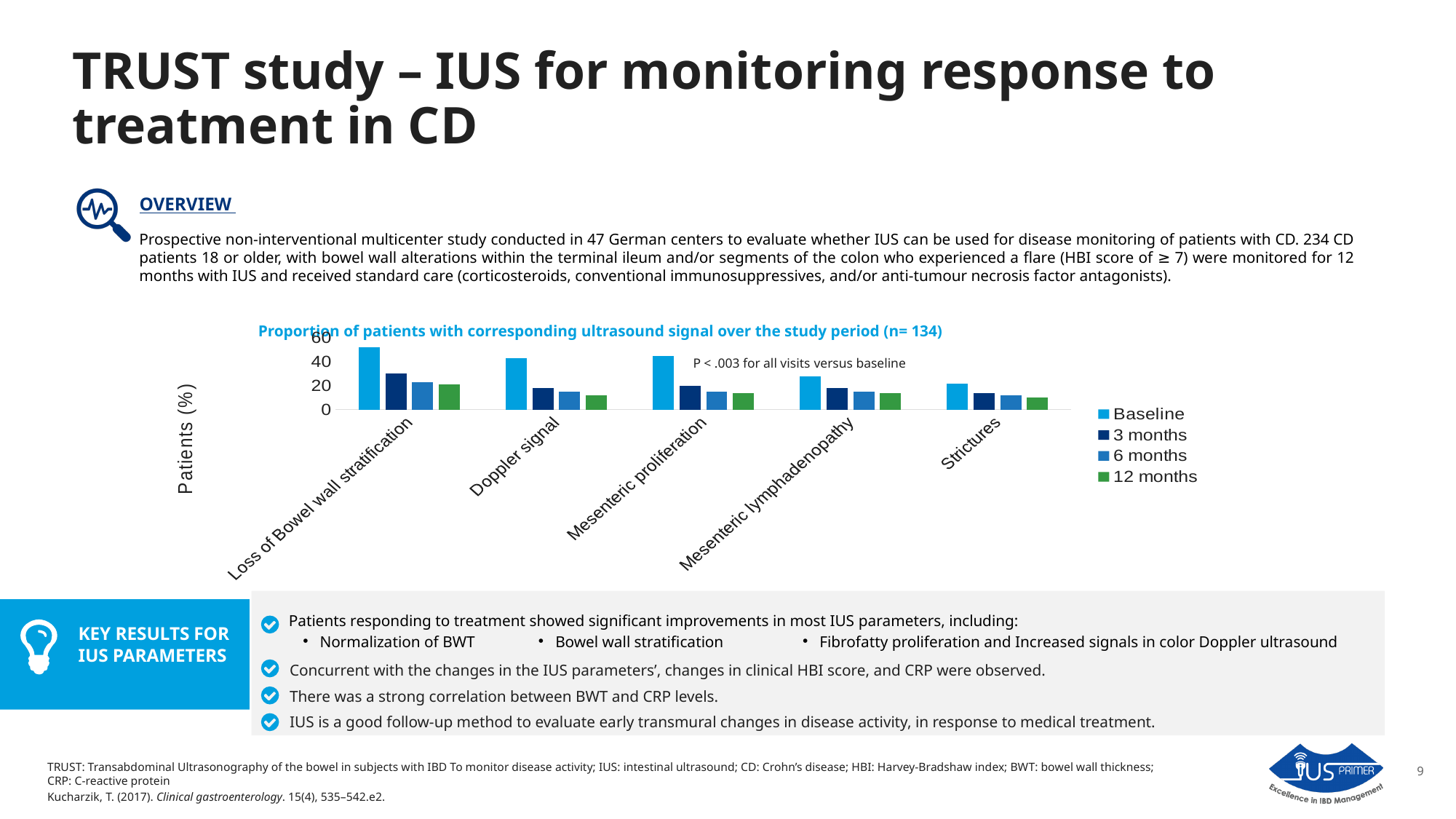
How many series does the chart legend list? 4 Which is larger: the Baseline value for Doppler signal or the Baseline value for Mesenteric lymphadenopathy? Doppler signal Is the Baseline value for Loss of Bowel wall stratification greater or less than 40? greater What is the sample size (n) stated in the chart title? 134 Is the 12 months value for Doppler signal greater or less than 20? less Which category has the highest Baseline value? Loss of Bowel wall stratification What is the label on the y axis of the chart? Patients (%) For Loss of Bowel wall stratification, do the values rise or fall from Baseline to 12 months? Fall Which category has the lowest Baseline value? Strictures What kind of chart is shown on the slide? Bar chart How many ultrasound signal categories are shown on the x axis of the chart? 5 Is the Baseline value for Strictures greater or less than 40? less